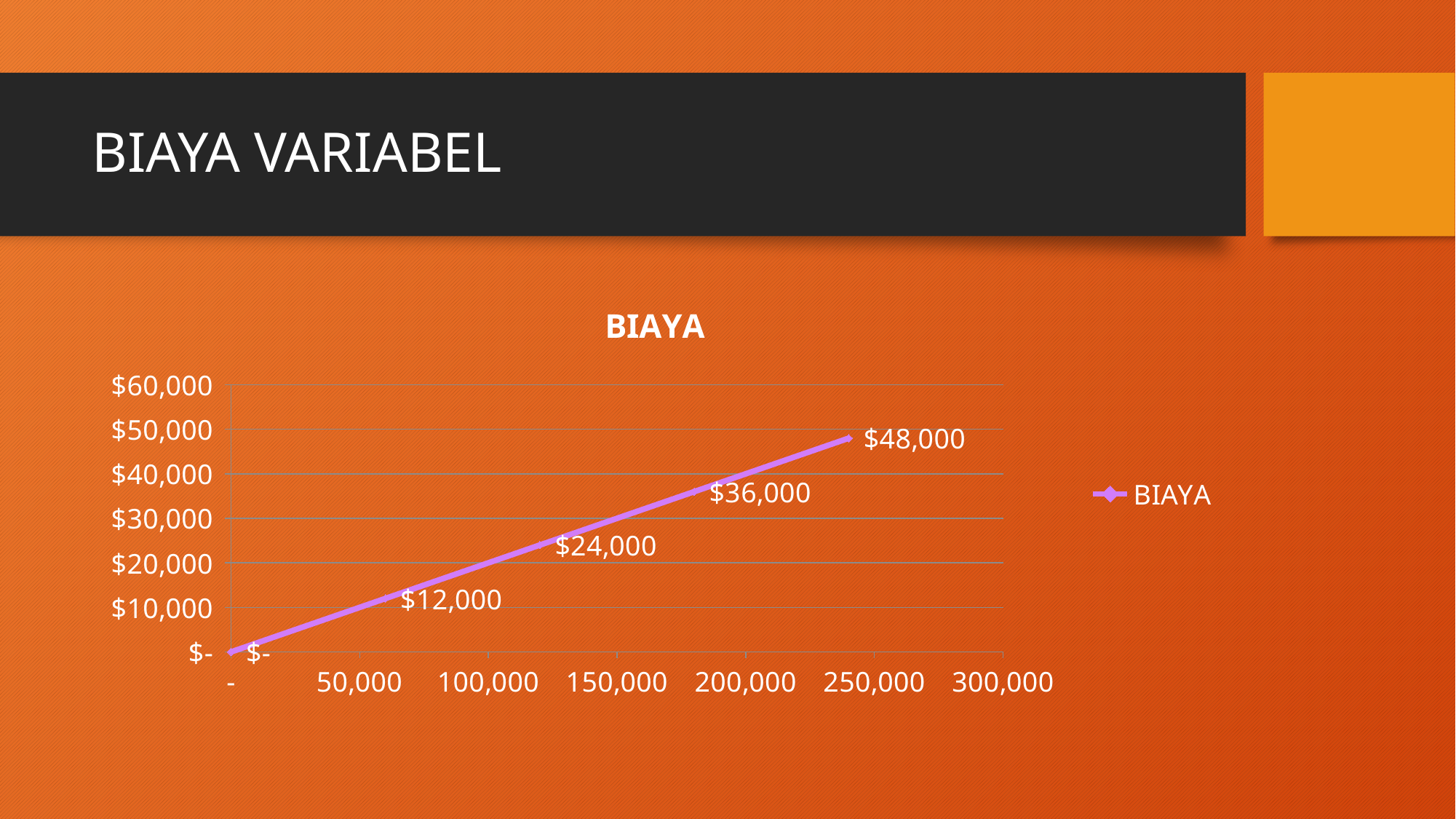
What is the difference between the labelled values $24,000 and $12,000? $12,000 How many series does the legend list? 1 What is the highest labelled value on the BIAYA line? $48,000 What is the difference between the highest labelled value ($48,000) and the next labelled value ($36,000)? $12,000 How many data points are labelled on the BIAYA line? 5 Do the BIAYA values rise or fall as the x-axis value increases? rise Which is larger, the labelled value $36,000 or the labelled value $24,000? $36,000 What kind of chart is shown on the slide? line chart What is the name of the series shown in the legend? BIAYA What is the lowest labelled value on the BIAYA line? $- What is the title of the chart? BIAYA Is the highest plotted BIAYA value greater or less than $50,000? less